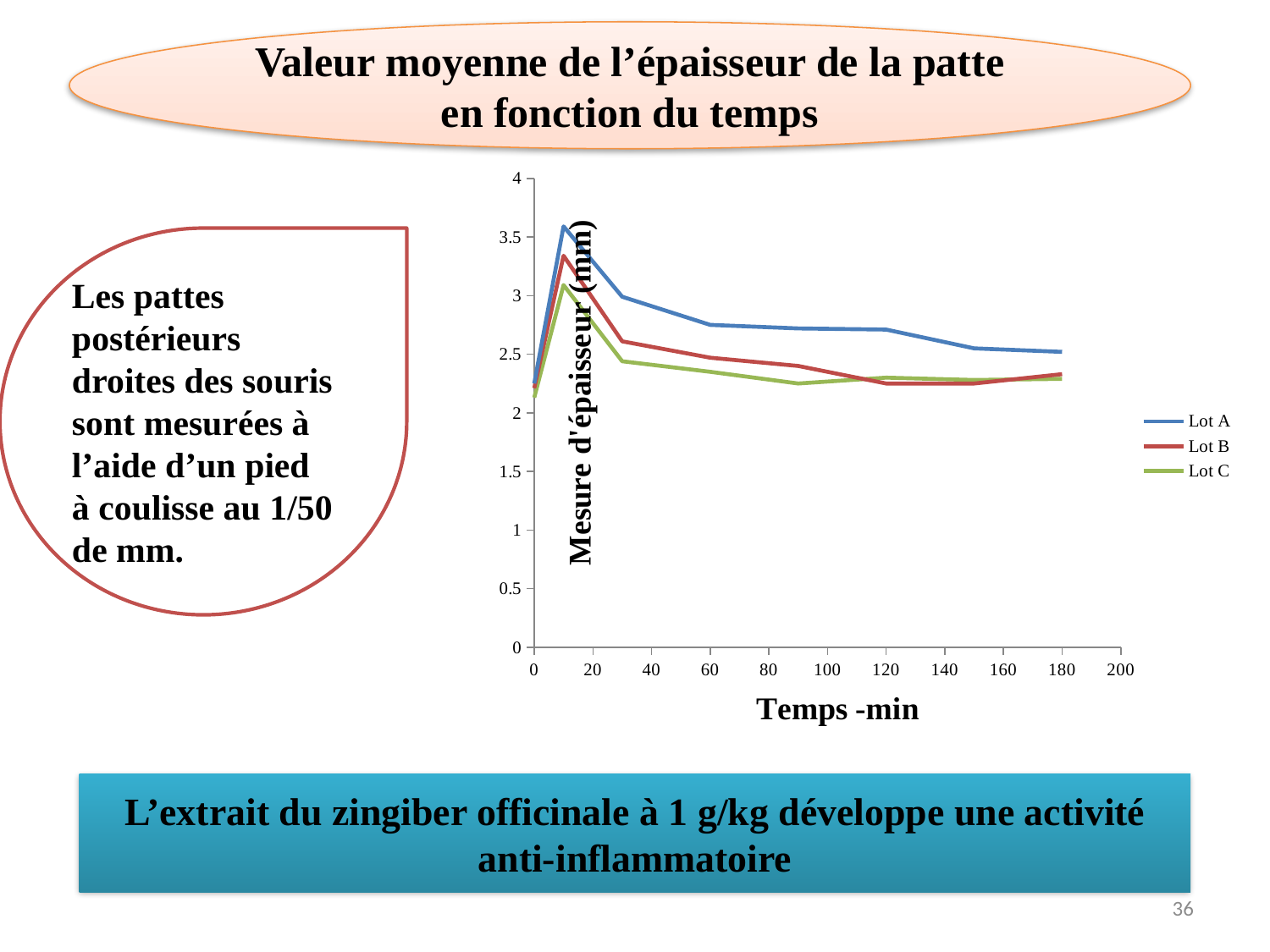
After the peak near 10 min, do the Lot A values rise or fall as time increases? fall Is the peak value of Lot A greater or less than 3? greater What is the title of the x axis? Temps -min Is the value for Lot B at 120 min greater or less than 2.5? less What are the series names listed in the legend? Lot A, Lot B, Lot C Which series reaches the highest peak value? Lot A At 60 min, which series has the larger value, Lot A or Lot C? Lot A Which series has the lowest value at 60 min? Lot C How many series does the legend list? 3 Is the peak value of Lot C greater or less than 3.5? less At 10 min, which series has the larger value, Lot B or Lot C? Lot B What kind of chart is shown on the slide? line chart